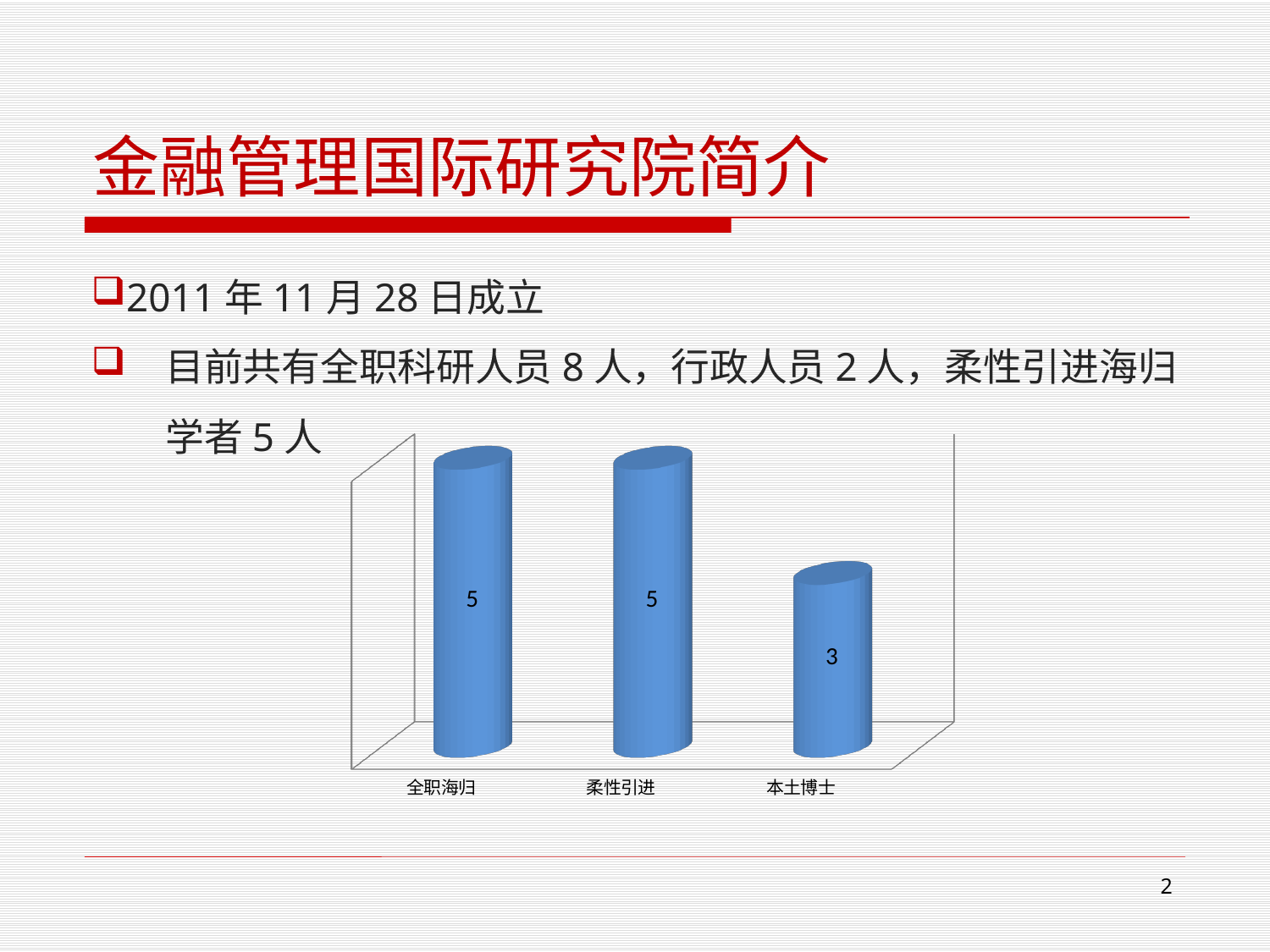
What is the value for 全职海归? 5 Which category has the lowest value? 本土博士 How many categories are shown in the chart? 3 Are the values for 全职海归 and 柔性引进 equal? yes What kind of chart is shown on the slide? bar chart What is the difference between the values for 全职海归 and 本土博士? 2 Do the values rise or fall from 柔性引进 to 本土博士? fall What colour are the bars in the chart? blue Which is larger, the value for 柔性引进 or the value for 本土博士? 柔性引进 What is the value for 本土博士? 3 What is the value for 柔性引进? 5 What is the total of the three values shown in the chart? 13